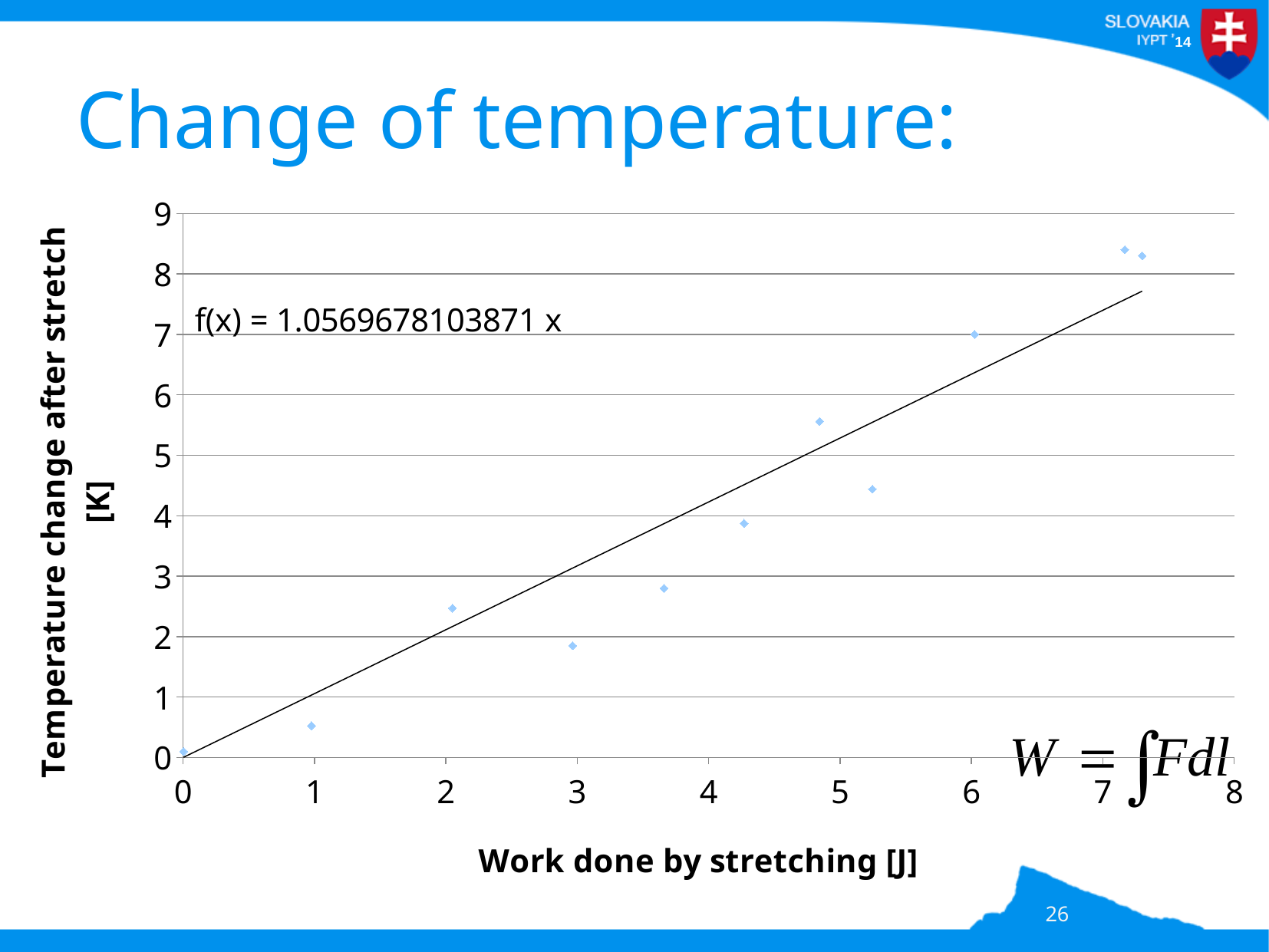
What is the maximum value shown on the y axis? 9 What kind of chart is shown on the slide? scatter chart Is the temperature change for the point at about 5.25 J greater or less than 4 K? greater Which has the larger temperature change: the point at about 4.85 J or the point at about 5.25 J? the point at about 4.85 J Which has the larger temperature change: the point at about 2 J or the point at about 3 J? the point at about 2 J Is the temperature change for the point at about 1 J greater or less than 1 K? less Is the temperature change for the point at about 2 J greater or less than 2 K? greater What is the title of the x axis? Work done by stretching [J] Do the plotted temperature changes generally rise or fall as the work done increases? rise What is the fitted line equation shown on the chart? f(x) = 1.0569678103871 x